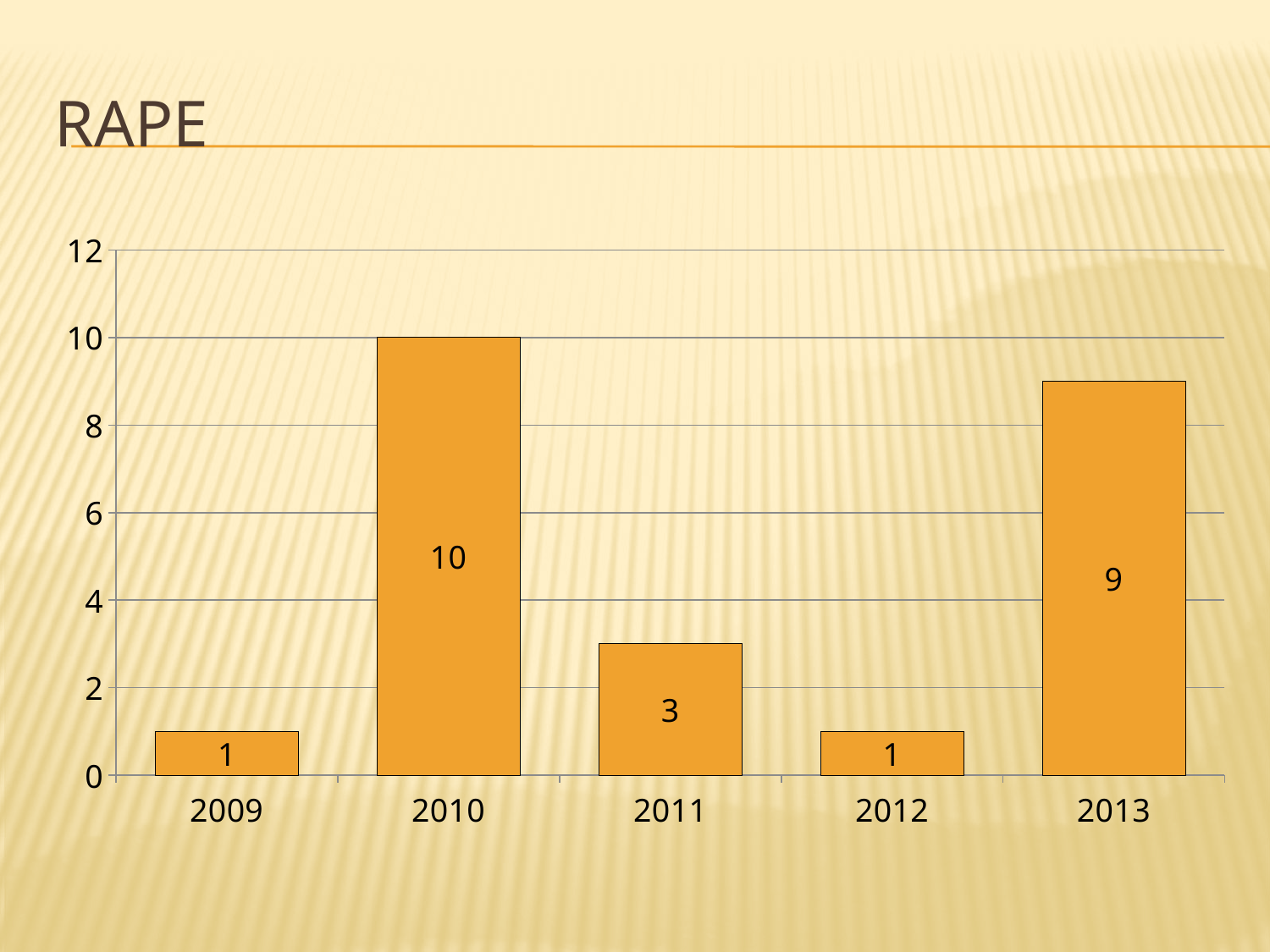
What kind of chart is shown on the slide? bar chart What is the value for 2010? 10 Which year has the highest value? 2010 Which is larger, the value for 2011 or the value for 2012? 2011 How many years are shown on the x axis? 5 What is the value for 2012? 1 What is the difference between the values for 2013 and 2011? 6 What is the title of the slide? RAPE What is the value for 2013? 9 What is the difference between the values for 2010 and 2013? 1 What is the value for 2011? 3 Is the value for 2013 greater or less than 8? greater